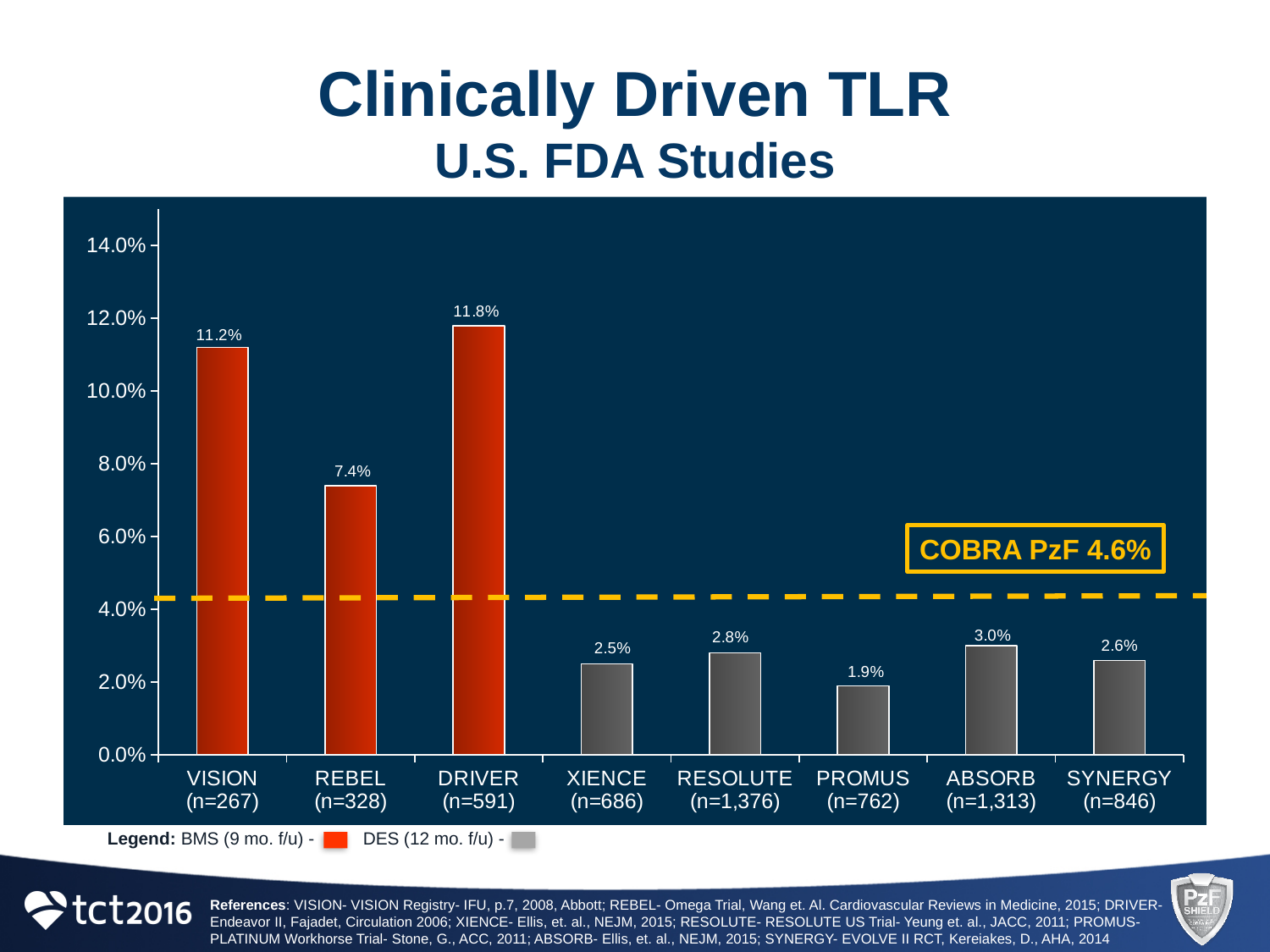
What is the difference between the TLR values for VISION and REBEL? 3.8% Which study has the highest clinically driven TLR? DRIVER What kind of chart is shown on the slide? bar chart How many series does the legend list? 2 Is the value for SYNERGY greater or less than 4.0%? less What is the clinically driven TLR value for DRIVER? 11.8% Which study has the lowest clinically driven TLR? PROMUS How many studies are shown on the x axis? 8 Which has a higher TLR value, RESOLUTE or XIENCE? RESOLUTE What TLR value is shown for COBRA PzF by the dashed line? 4.6% What is the clinically driven TLR value for PROMUS? 1.9% What is the clinically driven TLR value for ABSORB? 3.0%